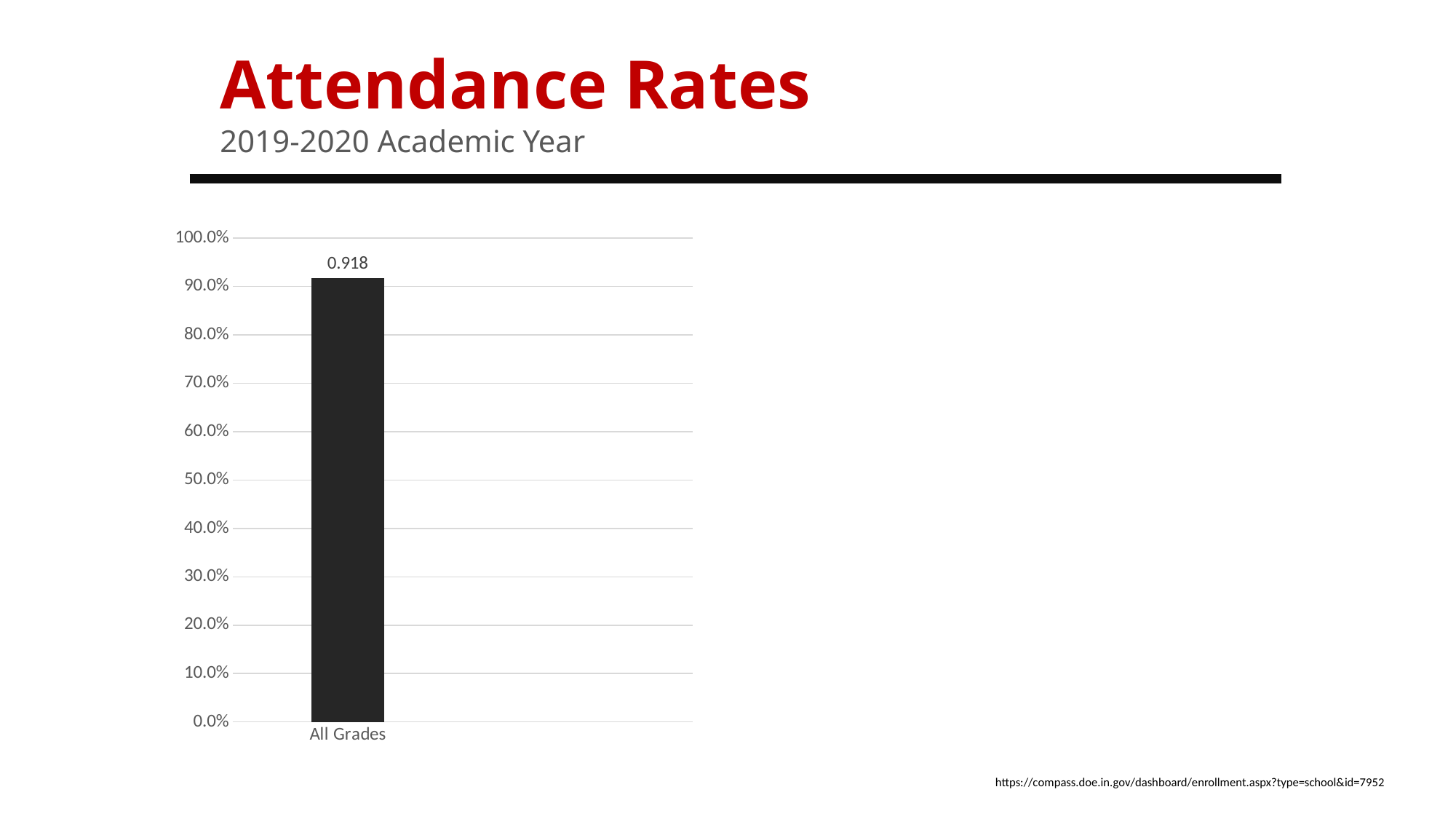
What is the highest value shown on the y axis? 100.0% How many bars does the chart show? 1 Is the value for All Grades greater or less than 100.0%? less Is the value for All Grades greater or less than 90.0%? greater Which category has the highest value in the chart? All Grades What is the data label shown on the bar for All Grades? 0.918 What kind of chart is shown on the slide? bar chart What is the label of the single category on the x axis? All Grades